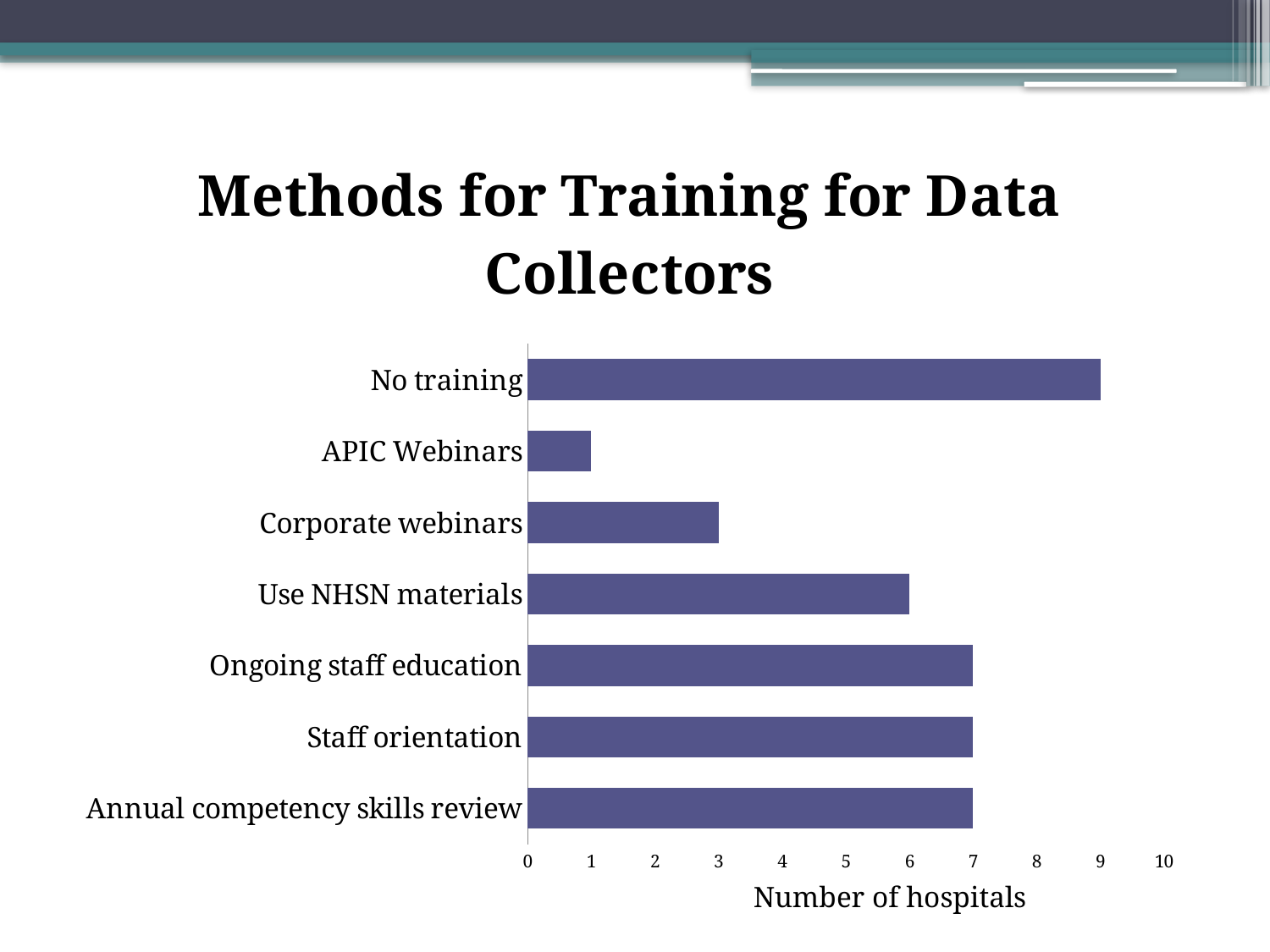
How many training methods (categories) are shown in the chart? 7 What is the label of the horizontal axis? Number of hospitals How many hospitals reported 'No training'? 9 How many hospitals reported using 'APIC Webinars'? 1 How many hospitals reported using 'Corporate webinars'? 3 What is the difference in the number of hospitals between 'No training' and 'Use NHSN materials'? 3 Which has more hospitals: 'Corporate webinars' or 'Staff orientation'? Staff orientation What type of chart is shown on the slide? Bar chart Which training method has the highest number of hospitals? No training How many hospitals reported 'Use NHSN materials'? 6 Which training method has the lowest number of hospitals? APIC Webinars What is the title of the chart? Methods for Training for Data Collectors